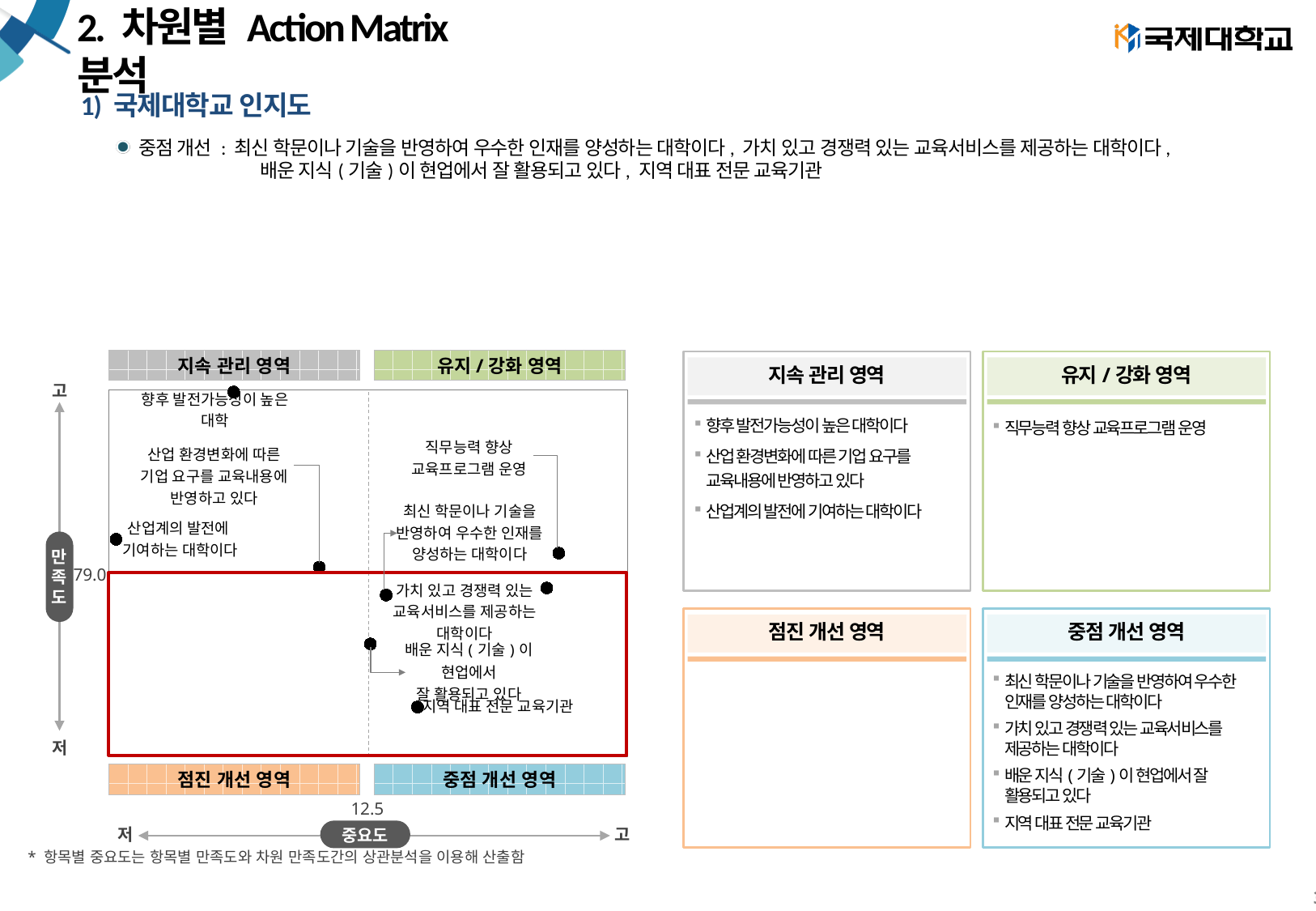
What is the label of the horizontal axis of the action matrix? 중요도 Which item has the highest satisfaction (만족도) in the matrix? 향후 발전가능성이 높은 대학 Is the importance (중요도) of 산업계의 발전에 기여하는 대학이다 greater or less than 12.5? less How many items are plotted in the action matrix? 8 Which quadrant of the action matrix contains no items? 점진 개선 영역 What is the label of the vertical axis of the action matrix? 만족도 How many items fall in the 지속 관리 영역 quadrant? 3 What satisfaction (만족도) value marks the horizontal dividing line of the matrix? 79.0 What importance (중요도) value marks the vertical dividing line of the matrix? 12.5 Which item has the lowest satisfaction (만족도) in the matrix? 지역 대표 전문 교육기관 What kind of chart is shown on the slide? scatter chart